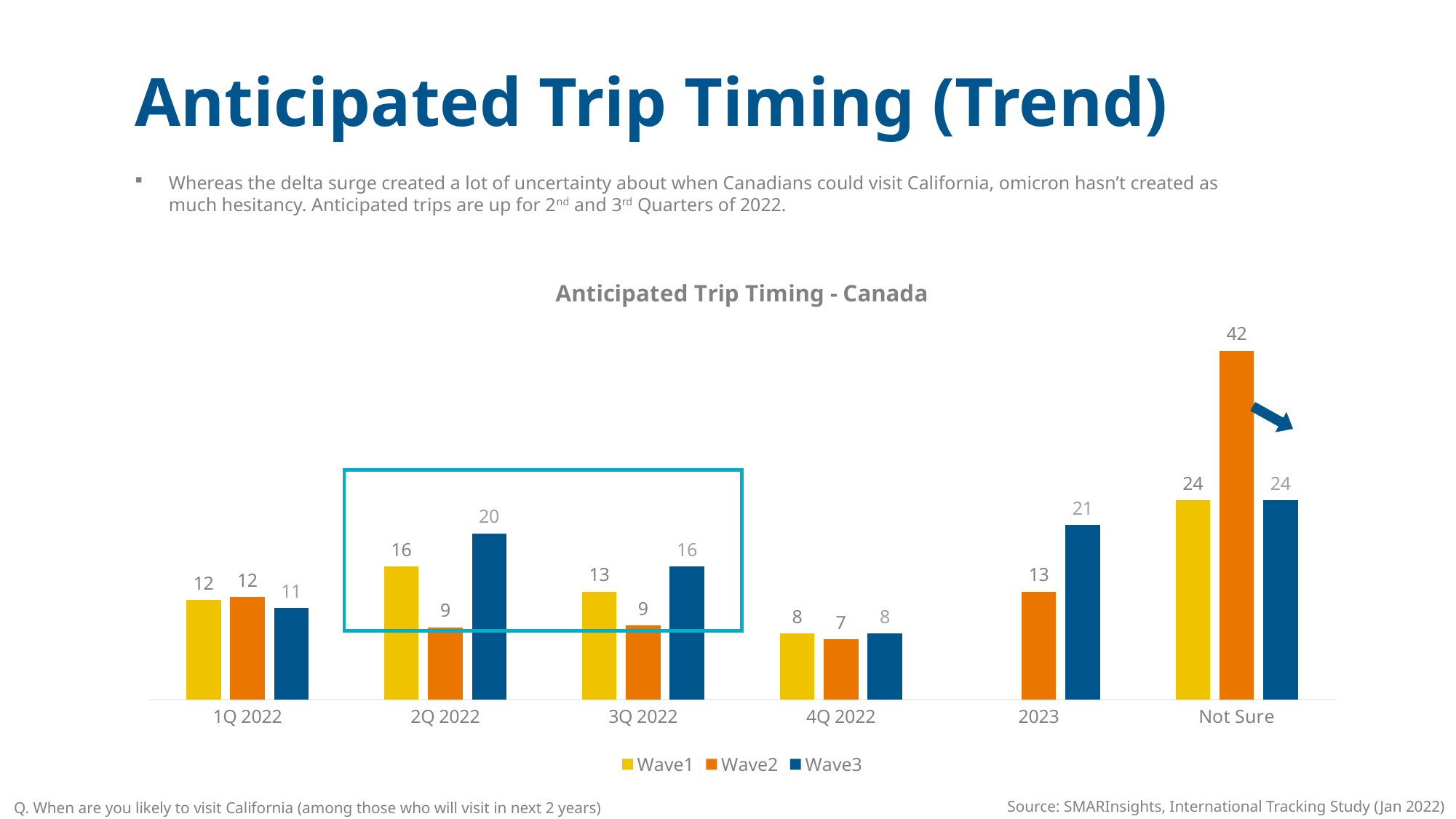
What is the Wave1 value for 3Q 2022? 13 What is the title of the chart? Anticipated Trip Timing - Canada What is the Wave2 value for 2023? 13 How many series does the legend list? 3 Which category has the highest Wave3 value? Not Sure Which category has the lowest Wave2 value? 4Q 2022 How many categories are shown on the x axis? 6 What is the difference between the Wave3 and Wave2 values for 2Q 2022? 11 What is the Wave3 value for 2Q 2022? 20 Which is larger for 3Q 2022, the Wave1 value or the Wave3 value? Wave3 What kind of chart is shown on the slide? Bar chart What is the Wave2 value for Not Sure? 42